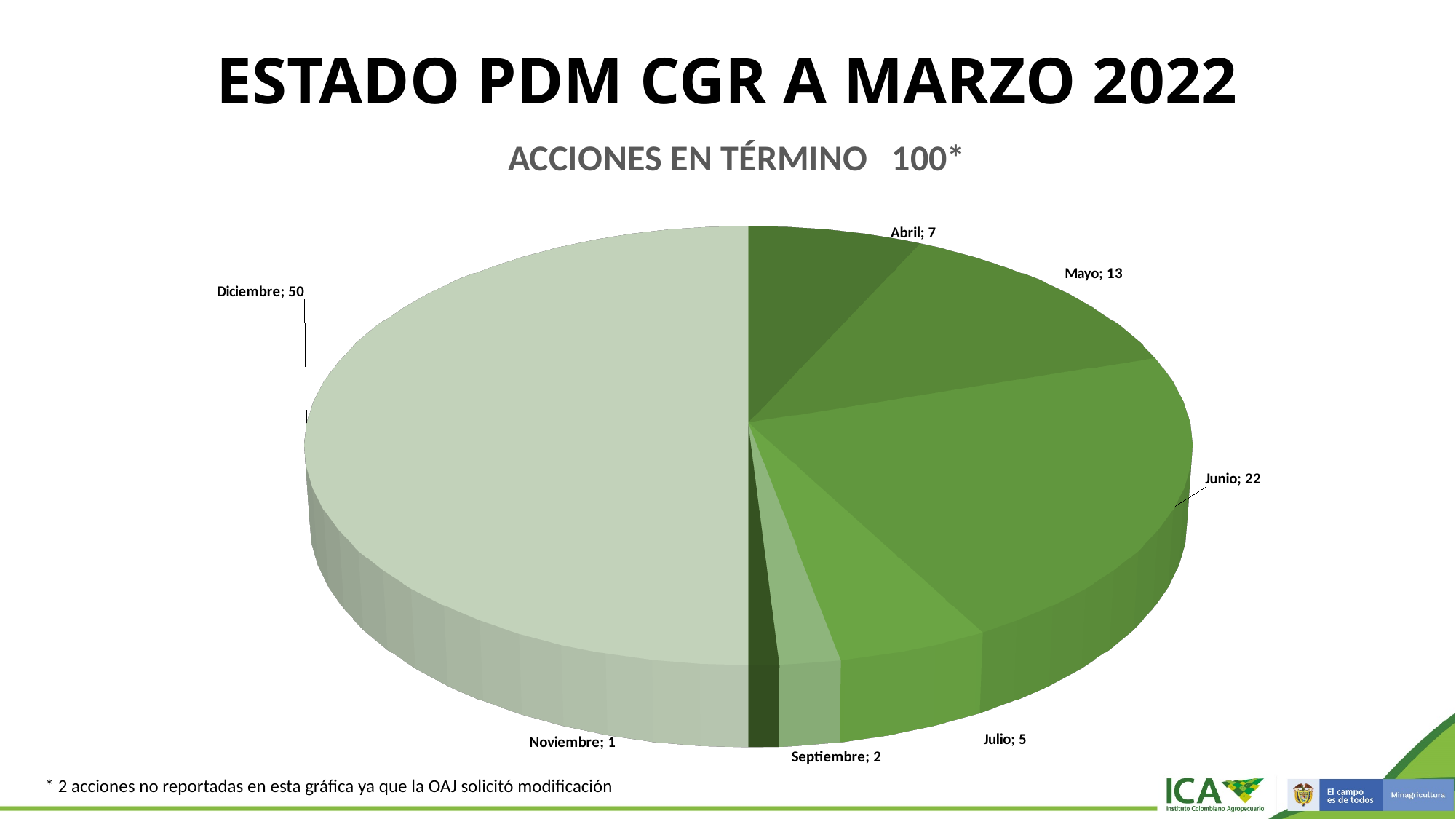
Which month has the largest slice in the pie chart? Diciembre What share of the pie does Diciembre represent? 50% What is the value for Diciembre in the pie chart? 50 Which month has the smallest slice in the pie chart? Noviembre What kind of chart is shown on the slide? Pie chart What is the total of all the slices in the pie chart? 100 Which is larger, the value for Abril or the value for Julio? Abril How many slices does the pie chart have? 7 What is the value for Junio in the pie chart? 22 What is the difference between the values for Junio and Mayo? 9 What is the title of the pie chart? ACCIONES EN TÉRMINO 100* What is the value for Septiembre in the pie chart? 2